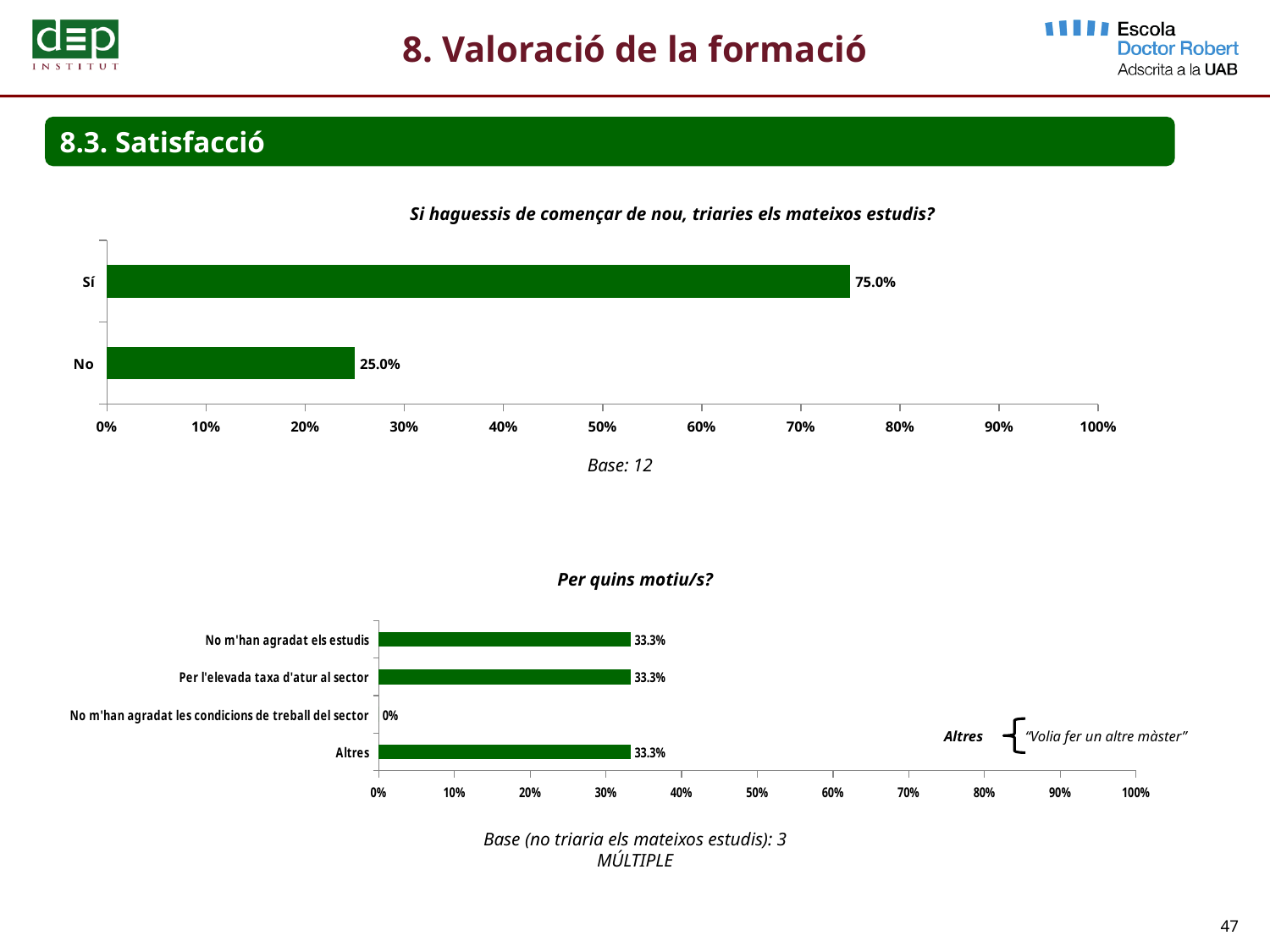
In the top chart 'Si haguessis de començar de nou, triaries els mateixos estudis?', what is the difference between the values for 'Sí' and 'No'? 50.0% What kind of chart is the top chart 'Si haguessis de començar de nou, triaries els mateixos estudis?'? Bar chart In the bottom chart 'Per quins motiu/s?', what is the value for 'No m'han agradat les condicions de treball del sector'? 0% In the bottom chart 'Per quins motiu/s?', what is the value for 'No m'han agradat els estudis'? 33.3% In the bottom chart 'Per quins motiu/s?', which category has the lowest value? No m'han agradat les condicions de treball del sector What is the base (number of respondents) stated below the top chart? 12 In the top chart 'Si haguessis de començar de nou, triaries els mateixos estudis?', how many categories are shown? 2 In the top chart 'Si haguessis de començar de nou, triaries els mateixos estudis?', what is the value for 'No'? 25.0% In the top chart 'Si haguessis de començar de nou, triaries els mateixos estudis?', what is the value for 'Sí'? 75.0% In the top chart 'Si haguessis de començar de nou, triaries els mateixos estudis?', which category has the highest value? Sí In the bottom chart 'Per quins motiu/s?', is the value for 'Altres' greater or less than 30%? greater In the bottom chart 'Per quins motiu/s?', how many categories are shown? 4